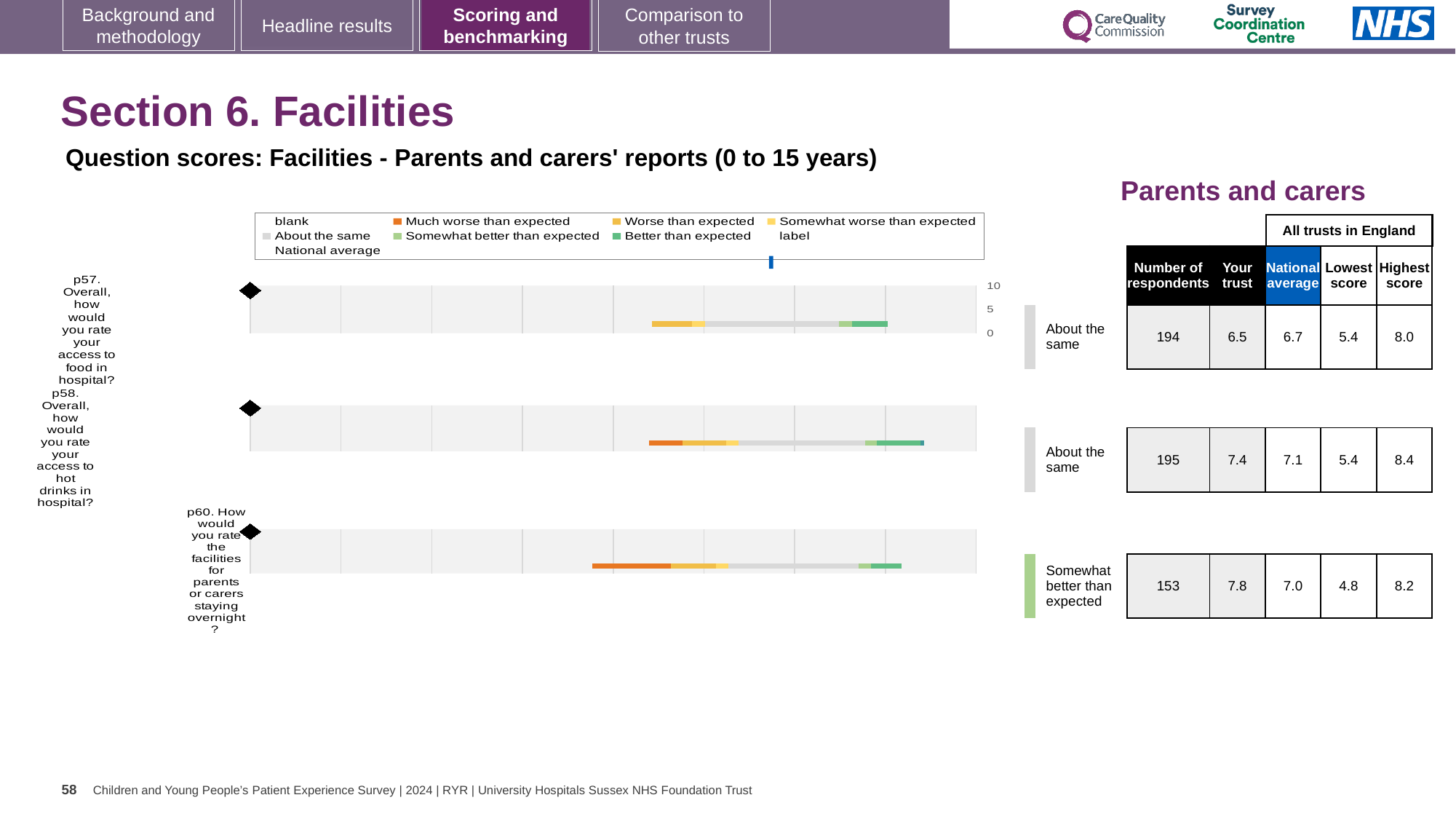
How many respondents answered p60 (facilities for parents or carers staying overnight)? 153 What type of chart is used to show the question scores on this slide? bar chart For p57, which is larger: the trust's score or the national average? National average How many questions (p57, p58, p60) have a score chart on this slide? 3 For p58, how much higher is the trust's score than the national average? 0.3 Which question has the highest 'Your trust' score? p60 Which legend entry is shown in orange? Much worse than expected What is the national average score for p58 (access to hot drinks in hospital)? 7.1 What is the 'Your trust' score for p57 (access to food in hospital)? 6.5 What is the maximum value shown on the score axis of the charts? 10 Which question has the lowest 'Highest score' across all trusts in England? p57 What benchmark category is given for p60? Somewhat better than expected